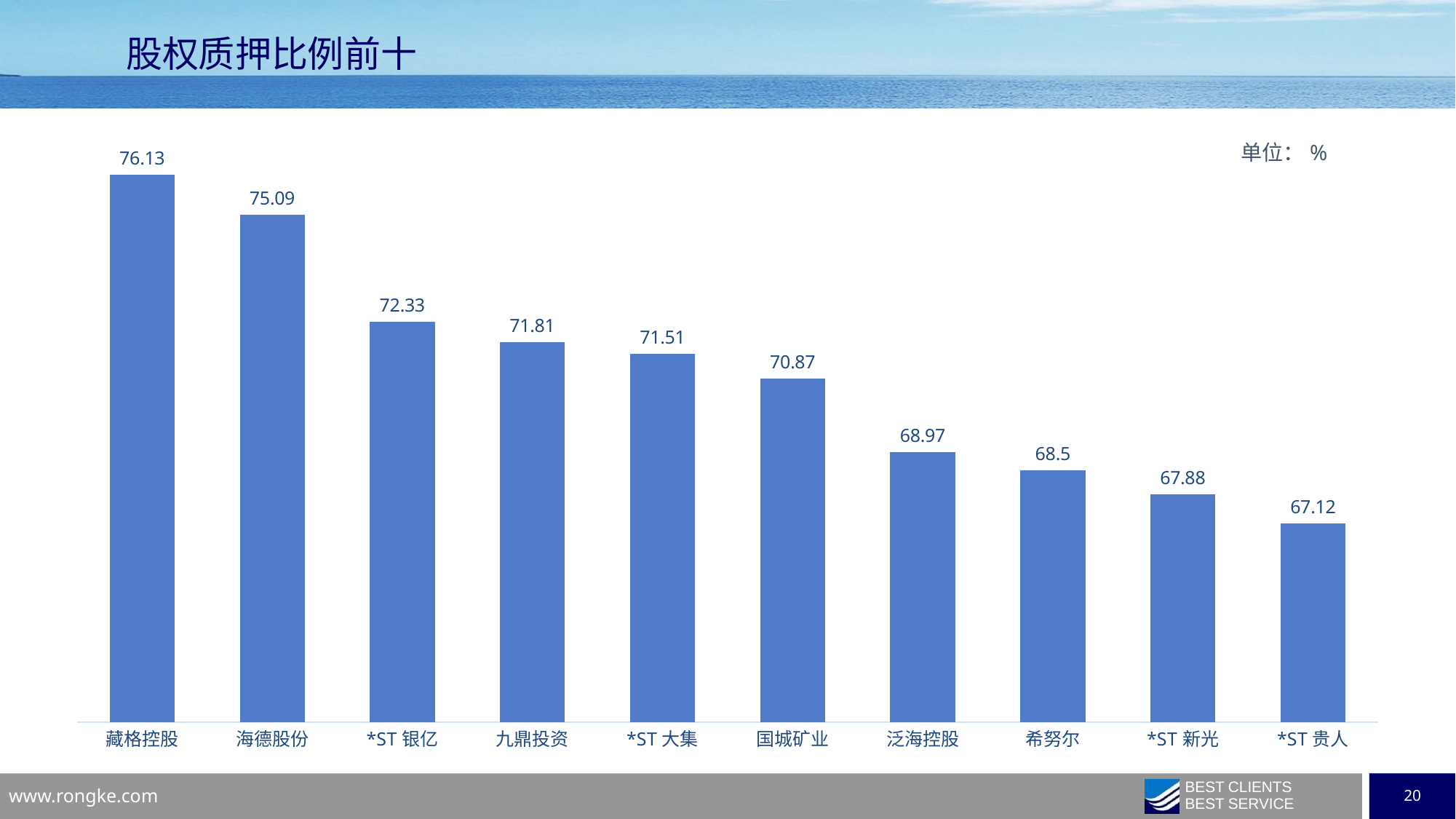
What is the difference between the values for *ST 银亿 and *ST 贵人? 5.21 What unit is stated for the values in the chart? % What kind of chart is shown on the slide? bar chart How many categories are shown in the chart? 10 What is the value for 希努尔? 68.5 Do the values rise or fall from left to right along the x axis? fall What is the value for 藏格控股? 76.13 What is the value for 国城矿业? 70.87 Which category has the highest value? 藏格控股 Which category has the lowest value? *ST 贵人 What is the difference between the values for 藏格控股 and 海德股份? 1.04 Which is larger, the value for 九鼎投资 or the value for 泛海控股? 九鼎投资